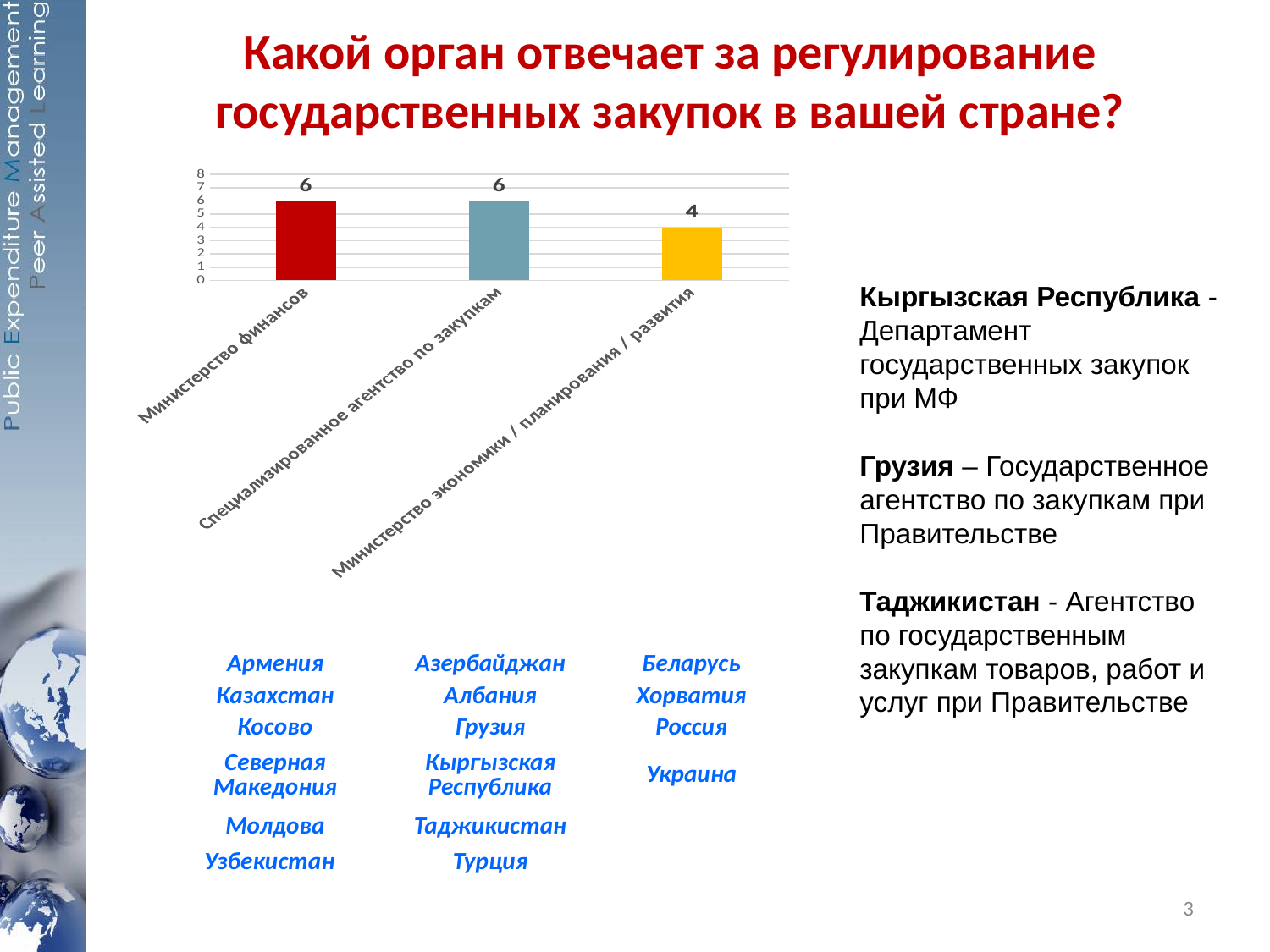
Which is larger: the value for Специализированное агентство по закупкам or the value for Министерство экономики / планирования / развития? Специализированное агентство по закупкам Is the value for Министерство экономики / планирования / развития greater or less than 5? less How many categories are shown in the chart? 3 What colour is the bar for Министерство финансов? red What kind of chart is shown on the slide? bar chart What value is shown for Специализированное агентство по закупкам? 6 What value is shown for Министерство экономики / планирования / развития? 4 What value is shown for Министерство финансов? 6 Which category has the lowest value? Министерство экономики / планирования / развития What is the difference between the values for Министерство финансов and Министерство экономики / планирования / развития? 2 What is the total of the three values shown in the chart? 16 What is the highest value shown on the vertical axis of the chart? 8